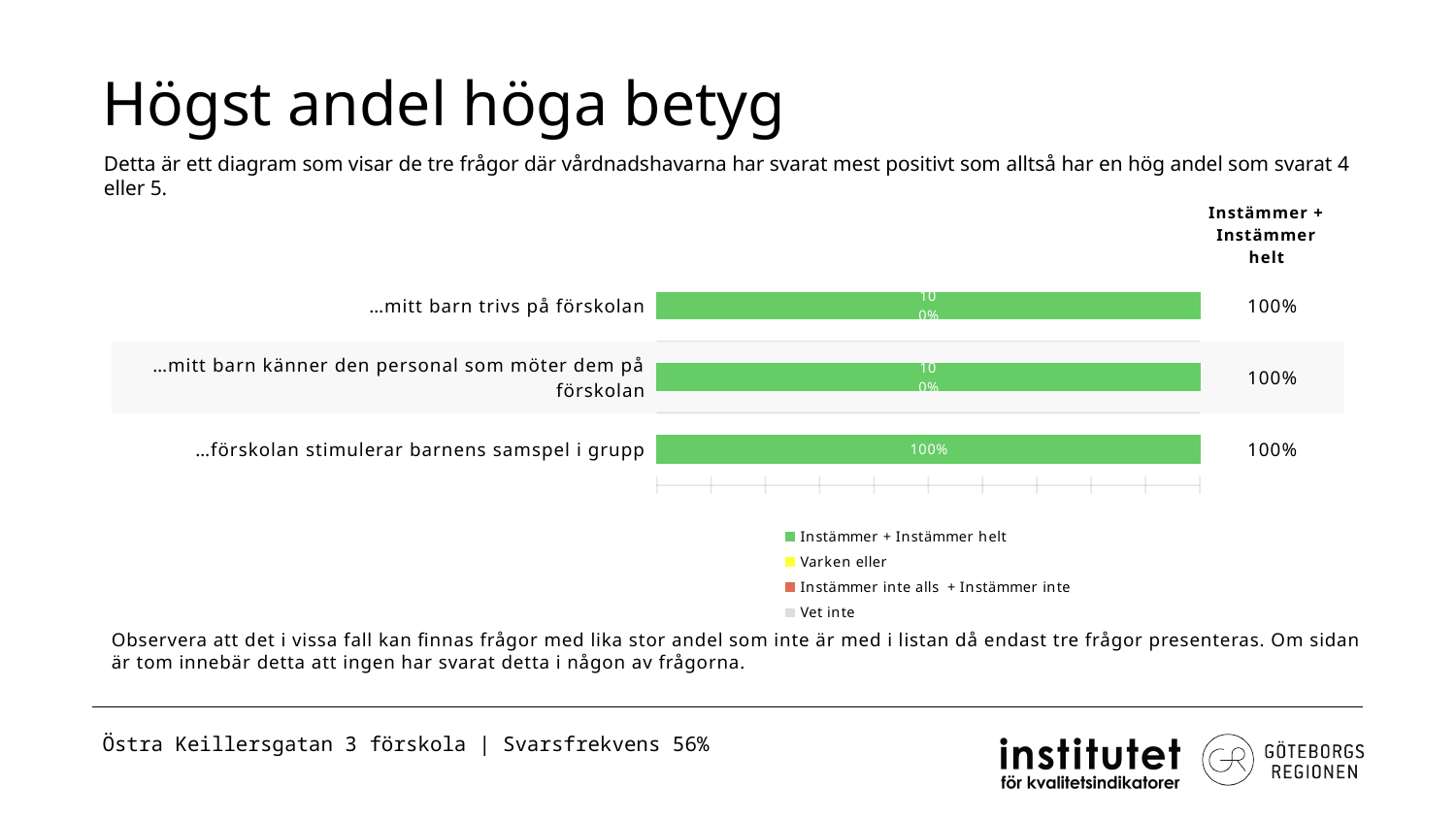
What kind of chart is shown on the slide? bar chart What is the 'Instämmer + Instämmer helt' value for '…mitt barn trivs på förskolan'? 100% What is the label of the last (bottom) category in the chart? …förskolan stimulerar barnens samspel i grupp How many series does the chart legend list? 4 What is the 'Instämmer + Instämmer helt' value for '…förskolan stimulerar barnens samspel i grupp'? 100% What is the 'Instämmer + Instämmer helt' value for '…mitt barn känner den personal som möter dem på förskolan'? 100% Which legend entry is shown in yellow? Varken eller What is the label of the first (top) category in the chart? …mitt barn trivs på förskolan How many categories (questions) are plotted in the chart? 3 Which legend entry is shown in green? Instämmer + Instämmer helt What is the difference between the 'Instämmer + Instämmer helt' values for '…mitt barn trivs på förskolan' and '…förskolan stimulerar barnens samspel i grupp'? 0%